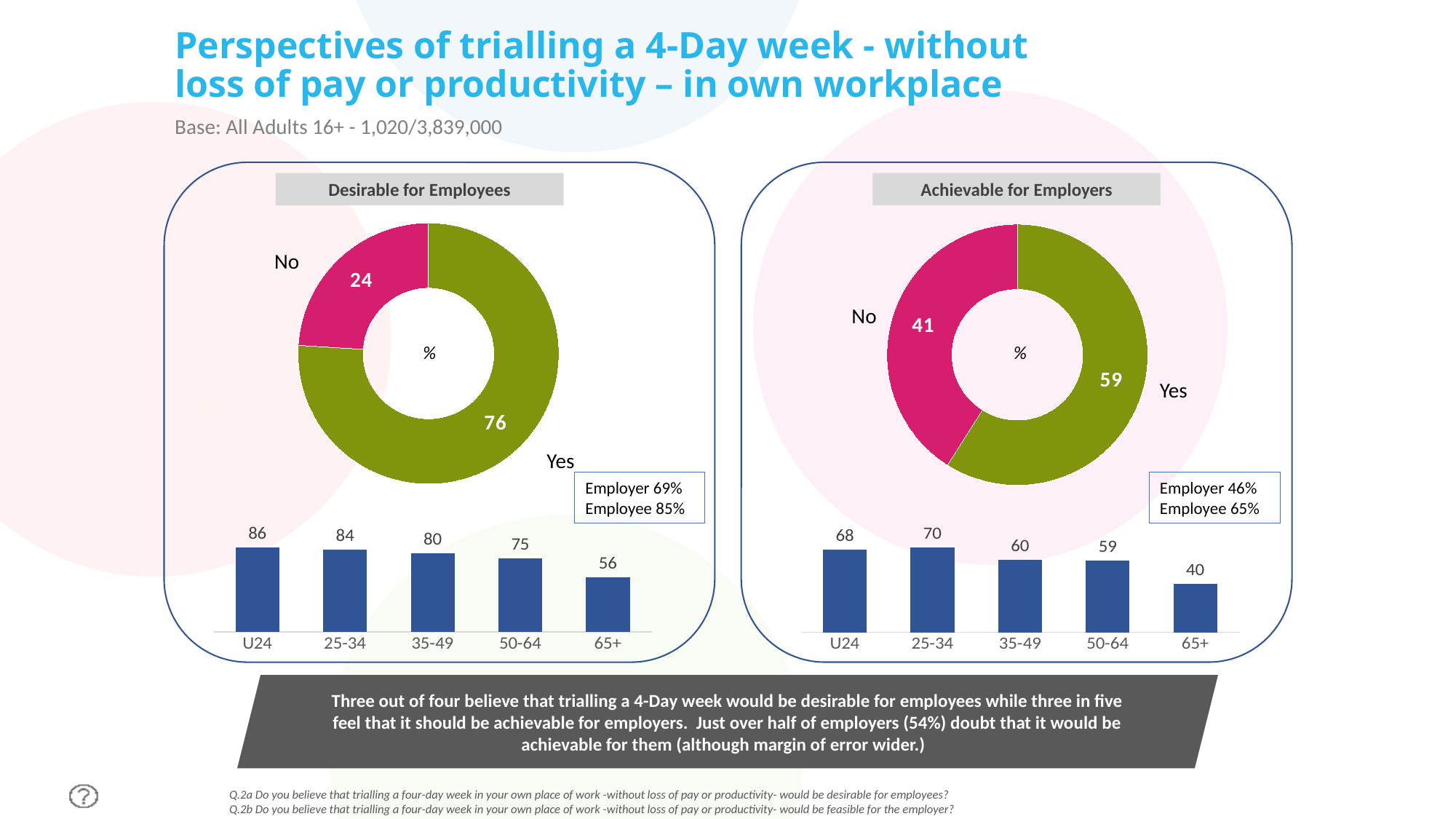
In the 'Desirable for Employees' donut chart, what percentage answered Yes? 76 In the 'Achievable for Employers' bar chart by age, which age group has the highest value? 25-34 In the 'Desirable for Employees' bar chart, do the values rise or fall from U24 to 65+? Fall In the 'Achievable for Employers' donut chart, which is larger, Yes or No? Yes In the 'Achievable for Employers' chart, what is the Employer percentage shown in the text box? 46% What type of chart is used to show the Yes/No split under 'Desirable for Employees'? Donut (pie) chart In the 'Desirable for Employees' bar chart by age, which age group has the lowest value? 65+ How many age groups are shown in the 'Achievable for Employers' bar chart? 5 In the 'Achievable for Employers' donut chart, what percentage answered No? 41 In the 'Desirable for Employees' bar chart by age, what is the value for the 65+ group? 56 In the 'Desirable for Employees' bar chart by age, what is the difference between the U24 and 65+ values? 30 In the 'Achievable for Employers' bar chart by age, what is the value for the 25-34 group? 70